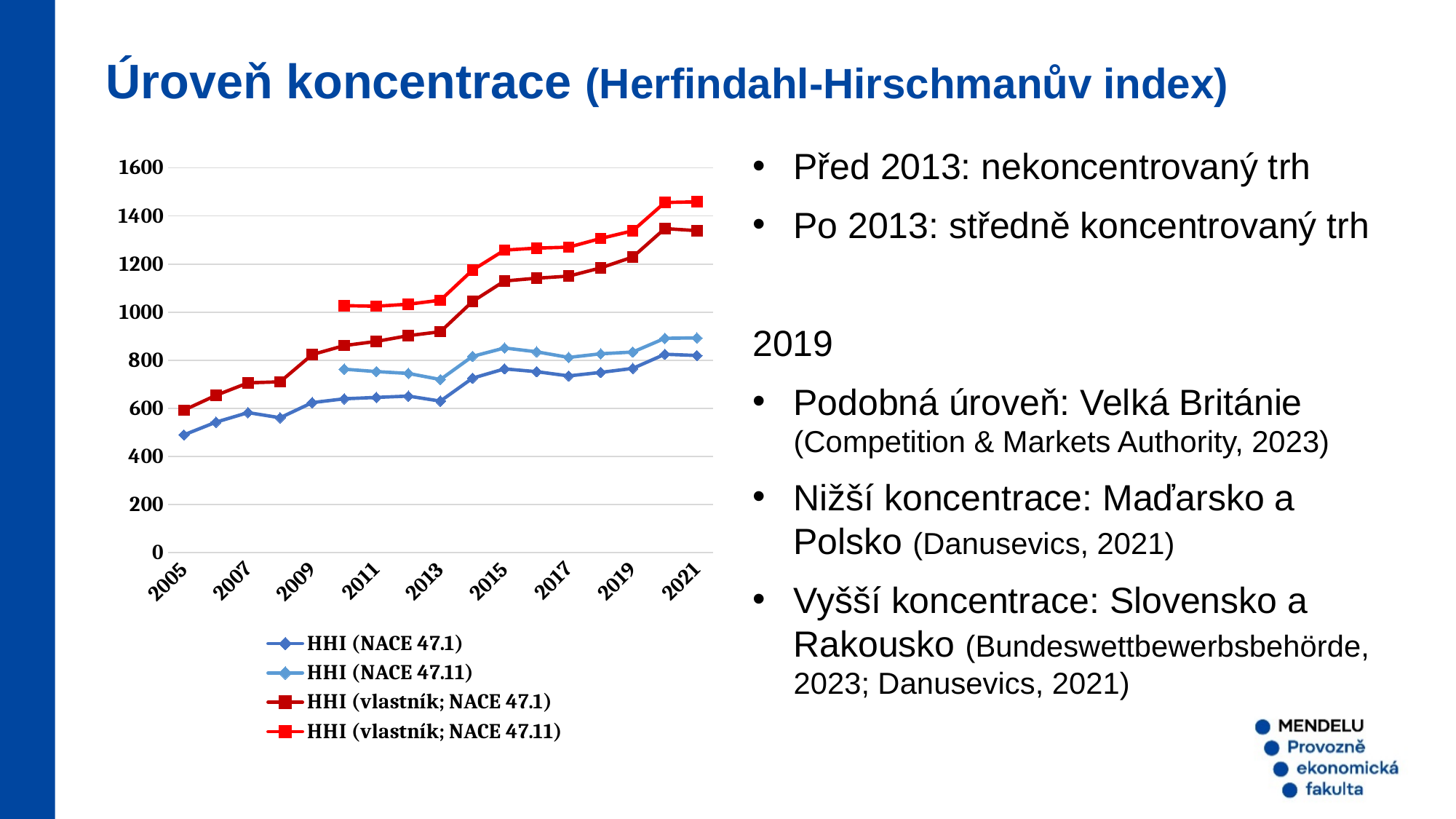
What kind of chart is shown on the slide? line chart Is the value for HHI (vlastník; NACE 47.11) in 2021 greater or less than 1400? greater Is the value for HHI (NACE 47.1) in 2005 greater or less than 600? less Which series has the lowest value in 2021? HHI (NACE 47.1) Does the HHI (vlastník; NACE 47.1) series rise or fall from 2005 to 2021? rise Is the value for HHI (NACE 47.11) in 2021 greater or less than 1000? less In 2021, which is larger: HHI (vlastník; NACE 47.11) or HHI (NACE 47.11)? HHI (vlastník; NACE 47.11) How many series does the chart legend list? 4 How many year labels are shown on the x axis of the chart? 9 What is the highest tick value shown on the y axis of the chart? 1600 Which series has the highest value in 2021? HHI (vlastník; NACE 47.11)